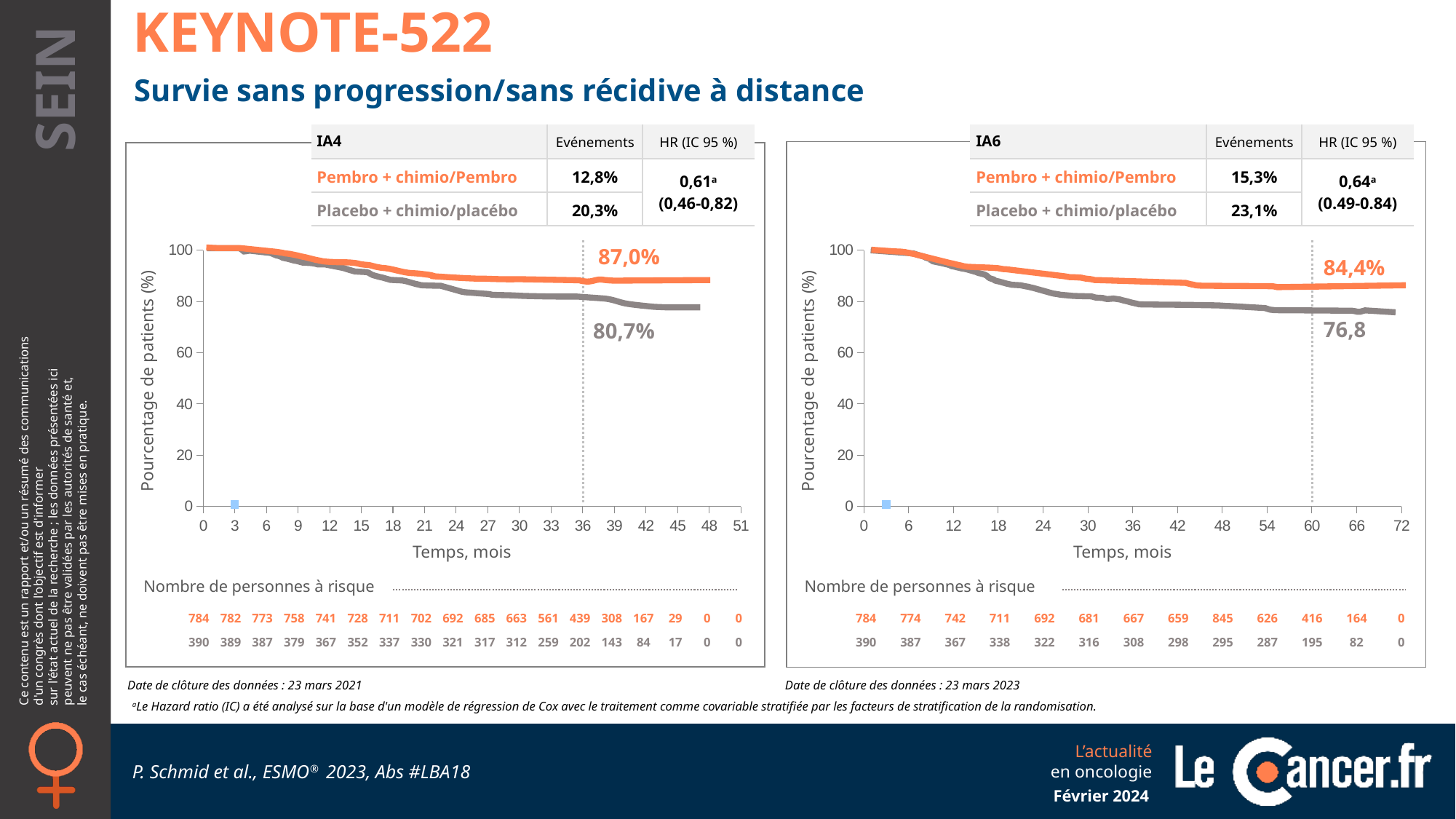
On the IA6 chart (right), what is the labelled value for the Placebo + chimio/placébo curve at 60 months? 76,8 On the IA6 chart (right), is the Placebo + chimio/placébo curve at 72 months greater or less than 80? less What kind of chart is shown on the IA4 panel (left)? Line chart On the IA4 chart (left), what is the event rate shown in the table for Pembro + chimio/Pembro? 12,8% On the IA4 chart (left), what is the difference between the labelled values of the two curves at 36 months? 6,3 points How many treatment arms (series) are plotted on the IA6 chart (right)? 2 On the IA6 chart (right), what is the hazard ratio shown in the table? 0,64 On the IA6 chart (right), which curve is higher at 60 months? Pembro + chimio/Pembro On the IA4 chart (left), do the curves rise or fall as time increases? Fall On the IA4 chart (left), what is the labelled percentage for the Placebo + chimio/placébo curve at 36 months? 80,7% On the IA4 chart (left), what is the labelled percentage for the Pembro + chimio/Pembro curve at 36 months? 87,0% On the IA6 chart (right), what is the labelled percentage for the Pembro + chimio/Pembro curve at 60 months? 84,4%